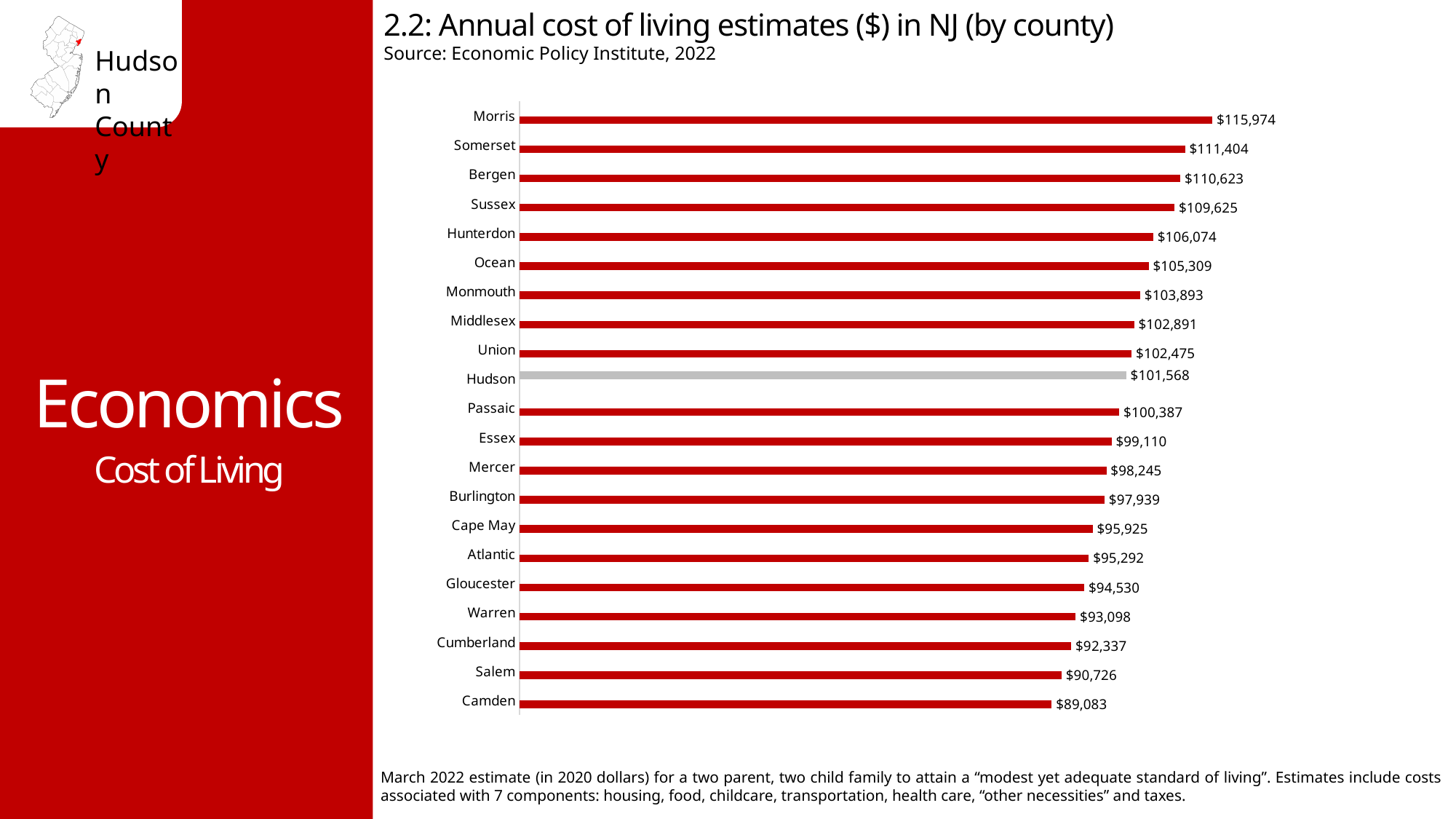
What is the difference between the cost of living estimates for Hudson and Passaic counties? $1,181 How many counties are shown in the chart? 21 What is the annual cost of living estimate for Cape May County? $95,925 What is the annual cost of living estimate for Hudson County? $101,568 What is the difference between the cost of living estimates for Morris and Camden counties? $26,891 Which county has a higher cost of living estimate, Ocean or Monmouth? Ocean Which county's bar is shown in gray rather than red? Hudson Which county has the highest annual cost of living estimate? Morris What type of chart is used to show the cost of living estimates? Bar chart What is the annual cost of living estimate for Bergen County? $110,623 Which county has a higher cost of living estimate, Salem or Warren? Warren Which county has the lowest annual cost of living estimate? Camden